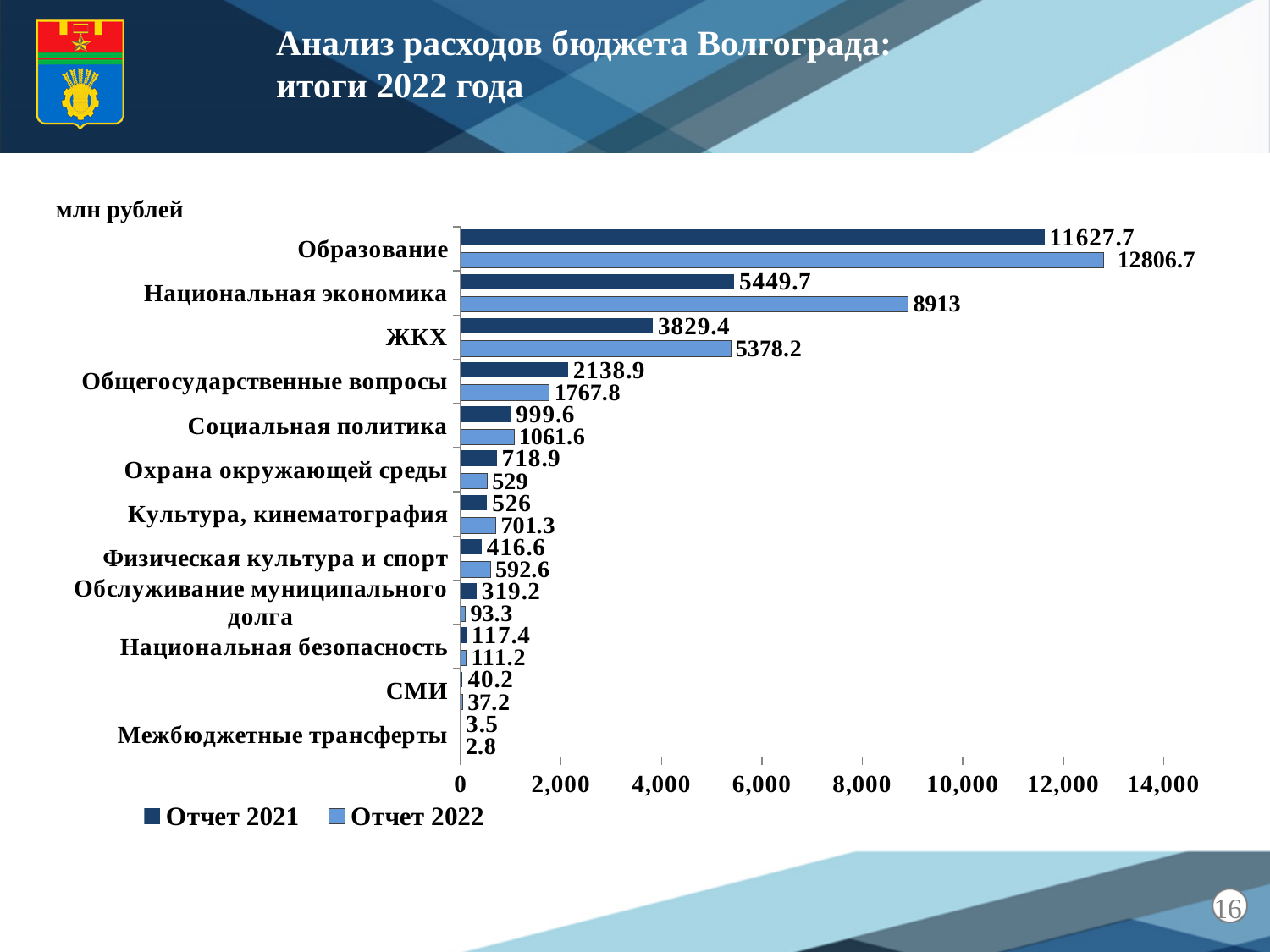
What is the value for Национальная экономика in the Отчет 2021 series? 5449.7 What is the value for Образование in the Отчет 2022 series? 12806.7 How many series does the legend list? 2 For Общегосударственные вопросы, which series has the larger value, Отчет 2021 or Отчет 2022? Отчет 2021 What kind of chart is shown on the slide? Bar chart Which category has the lowest value in the Отчет 2021 series? Межбюджетные трансферты What is the difference between the Отчет 2022 and Отчет 2021 values for Национальная экономика? 3463.3 How many categories are shown on the chart? 12 What is the difference between the Отчет 2022 and Отчет 2021 values for Образование? 1179 What is the value for Межбюджетные трансферты in the Отчет 2021 series? 3.5 What is the value for ЖКХ in the Отчет 2022 series? 5378.2 Which category has the highest value in the Отчет 2022 series? Образование